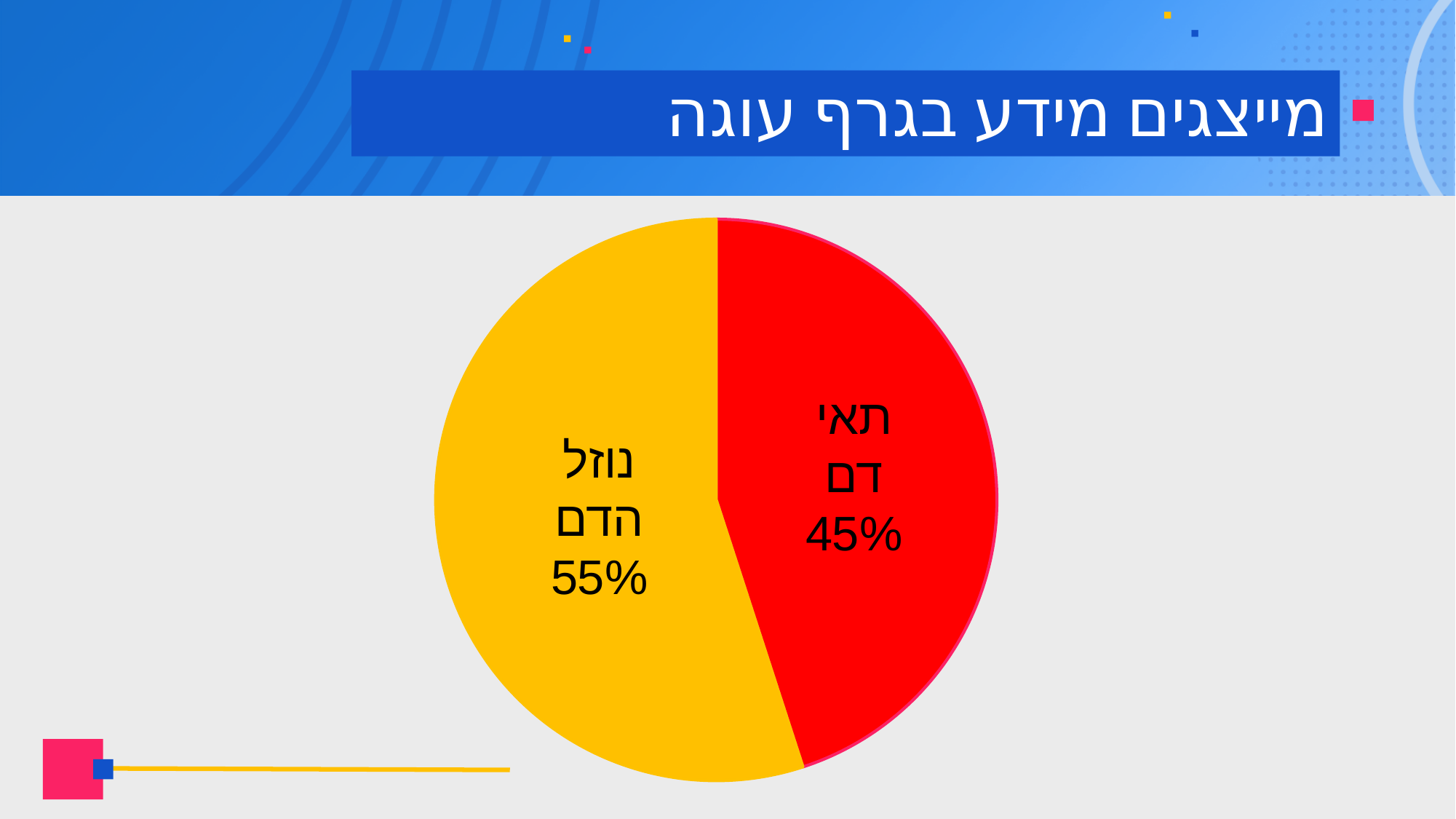
How many slices does the pie chart have? 2 What colour is the נוזל הדם slice? yellow What is the difference in percentage points between the נוזל הדם slice and the תאי דם slice? 10 What kind of chart is shown on the slide? pie chart Which slice of the pie is the smallest? תאי דם What share of the pie does the תאי דם slice take? 45% What percentage of the pie is labelled נוזל הדם? 55% Which is larger, the נוזל הדם slice or the תאי דם slice? נוזל הדם What colour is the תאי דם slice? red Which slice of the pie is the largest? נוזל הדם What percentage of the pie is labelled תאי דם? 45%